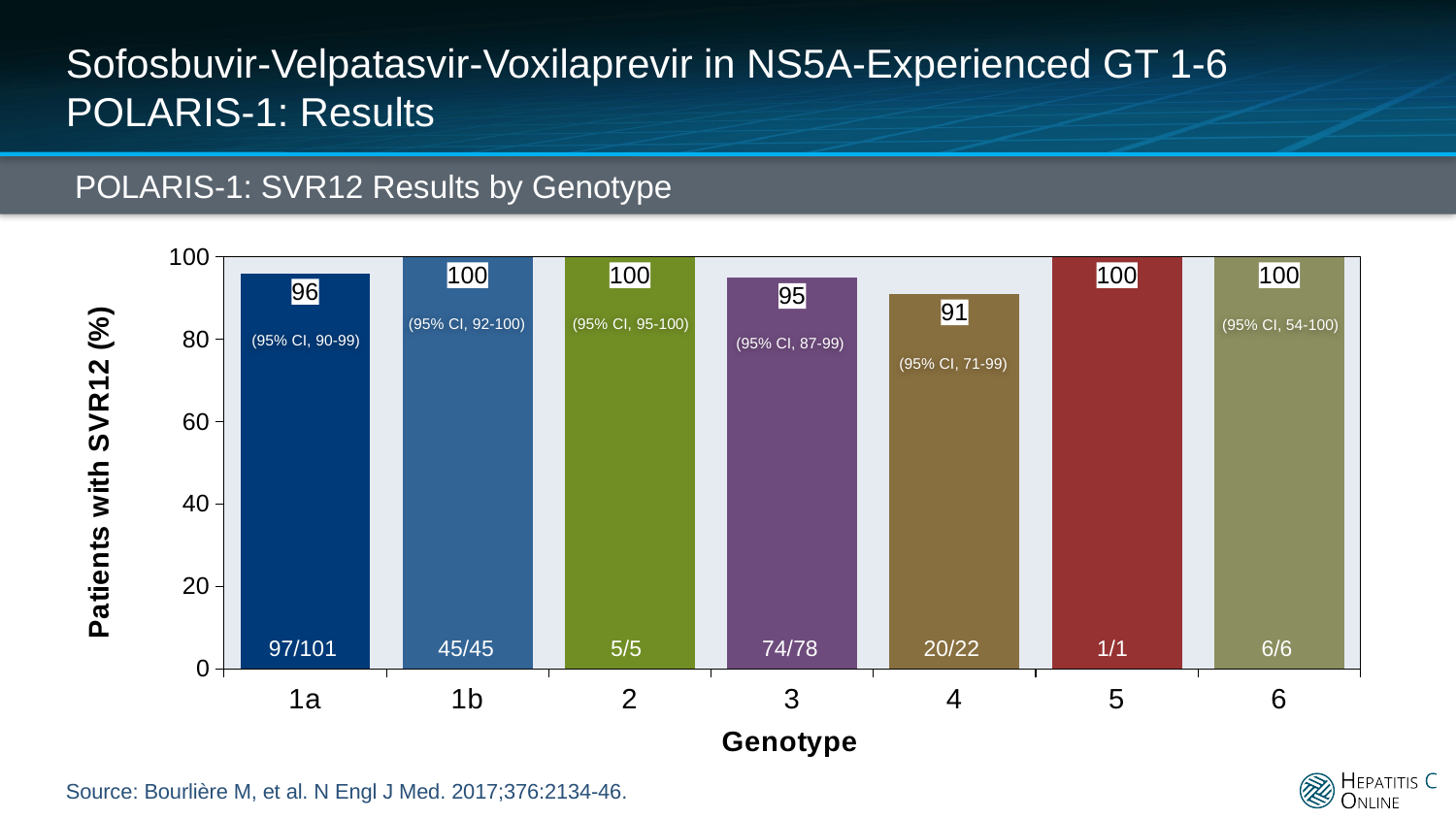
What is the SVR12 rate for genotype 1a? 96 What is the SVR12 rate for genotype 3? 95 What kind of chart is shown on the slide? bar chart What is the SVR12 rate for genotype 4? 91 What is the difference in SVR12 rate between genotype 1b and genotype 4? 9 What is the difference in SVR12 rate between genotype 1a and genotype 3? 1 Which genotype has the lowest SVR12 rate? 4 What is the 95% confidence interval shown for genotype 6? (95% CI, 54-100) How many patients achieved SVR12 in genotype 3, as shown by the fraction on the bar? 74/78 Which has a higher SVR12 rate, genotype 1a or genotype 4? 1a How many genotype categories are shown on the x axis? 7 What is the label of the y axis? Patients with SVR12 (%)